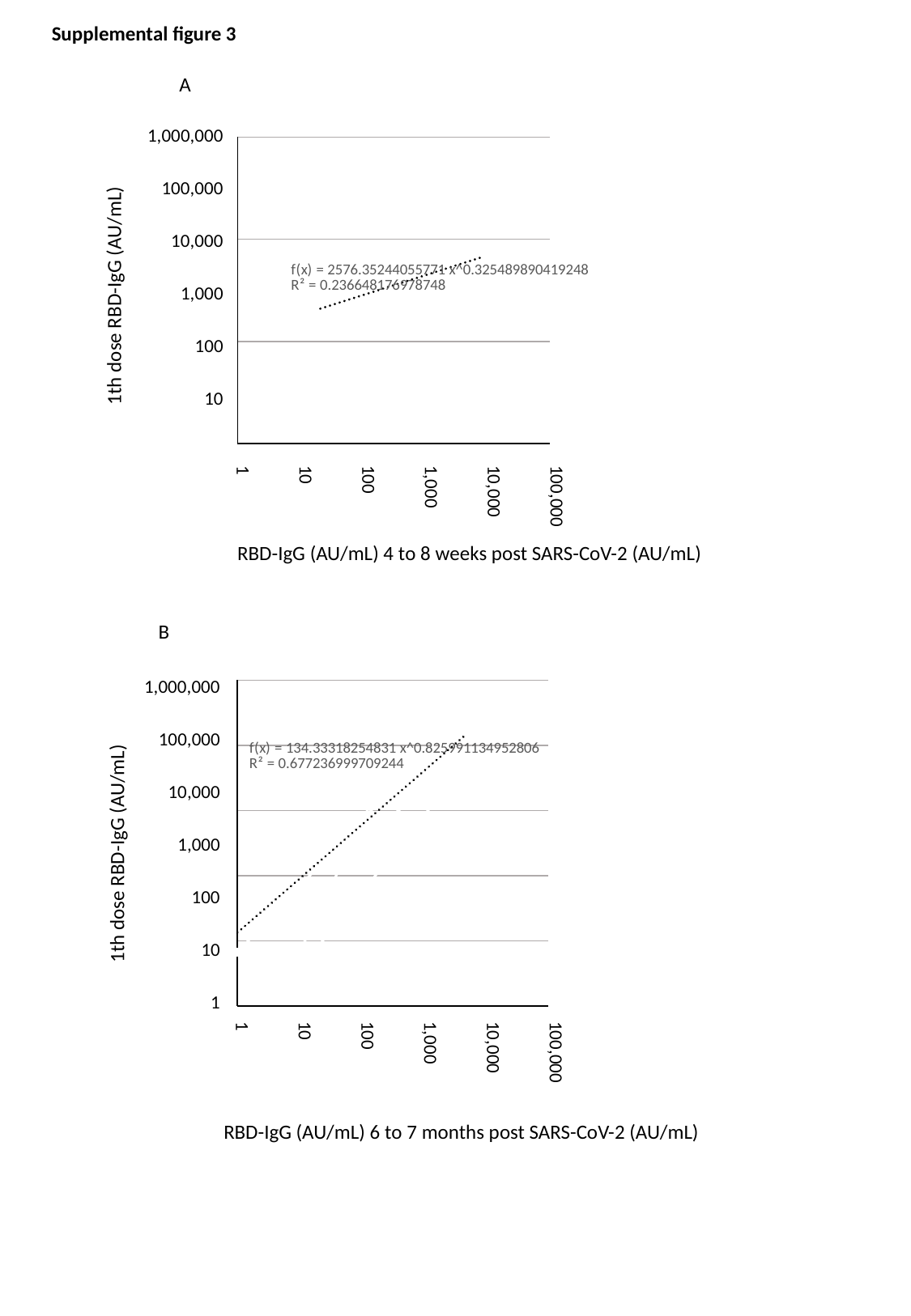
What is the y-axis title of chart A (top)? 1th dose RBD-IgG (AU/mL) What is the x-axis title of chart B (bottom)? RBD-IgG (AU/mL) 6 to 7 months post SARS-CoV-2 (AU/mL) In chart A (top), does the dotted trendline rise or fall as the x-axis value increases? rise In chart B (bottom), does the dotted trendline rise or fall as the x-axis value increases? rise In chart A (top), what is the exponent of x in the fitted equation f(x)? 0.325489890419248 In chart B (bottom), what is the coefficient in the fitted equation f(x)? 134.33318254831 Which chart has the higher R² value, chart A (top) or chart B (bottom)? chart B (bottom) What kind of chart is chart A (top)? scatter chart with a trendline In chart B (bottom), what is the R² value printed on the chart? 0.677236999709244 In chart A (top), what is the R² value printed on the chart? 0.236648176978748 What is the highest tick label on the y-axis of chart B (bottom)? 1,000,000 How many charts are shown on the slide? 2